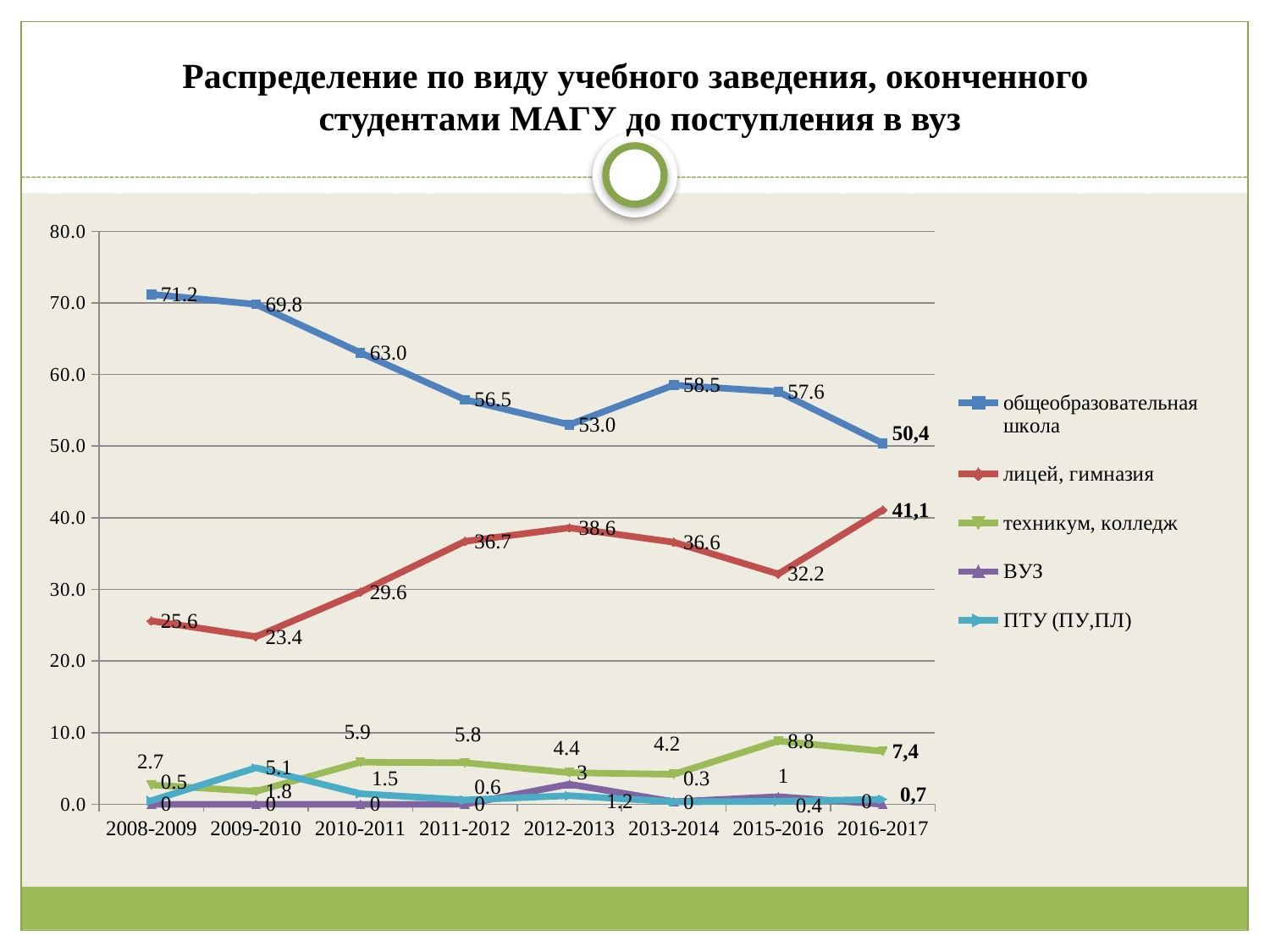
Which series is drawn in red? лицей, гимназия How many series does the legend list? 5 Does the value for общеобразовательная школа generally rise or fall from 2008-2009 to 2016-2017? fall What is the value for лицей, гимназия in 2016-2017? 41,1 What type of chart is shown on the slide? line chart In which academic year is the value for общеобразовательная школа the lowest? 2016-2017 What is the value for общеобразовательная школа in 2008-2009? 71.2 How many academic years are shown on the x axis? 8 In which academic year is the value for лицей, гимназия the highest? 2016-2017 What is the value for техникум, колледж in 2015-2016? 8.8 Which is larger in 2012-2013: общеобразовательная школа or лицей, гимназия? общеобразовательная школа What is the difference between the общеобразовательная школа values in 2008-2009 and 2016-2017? 20.8